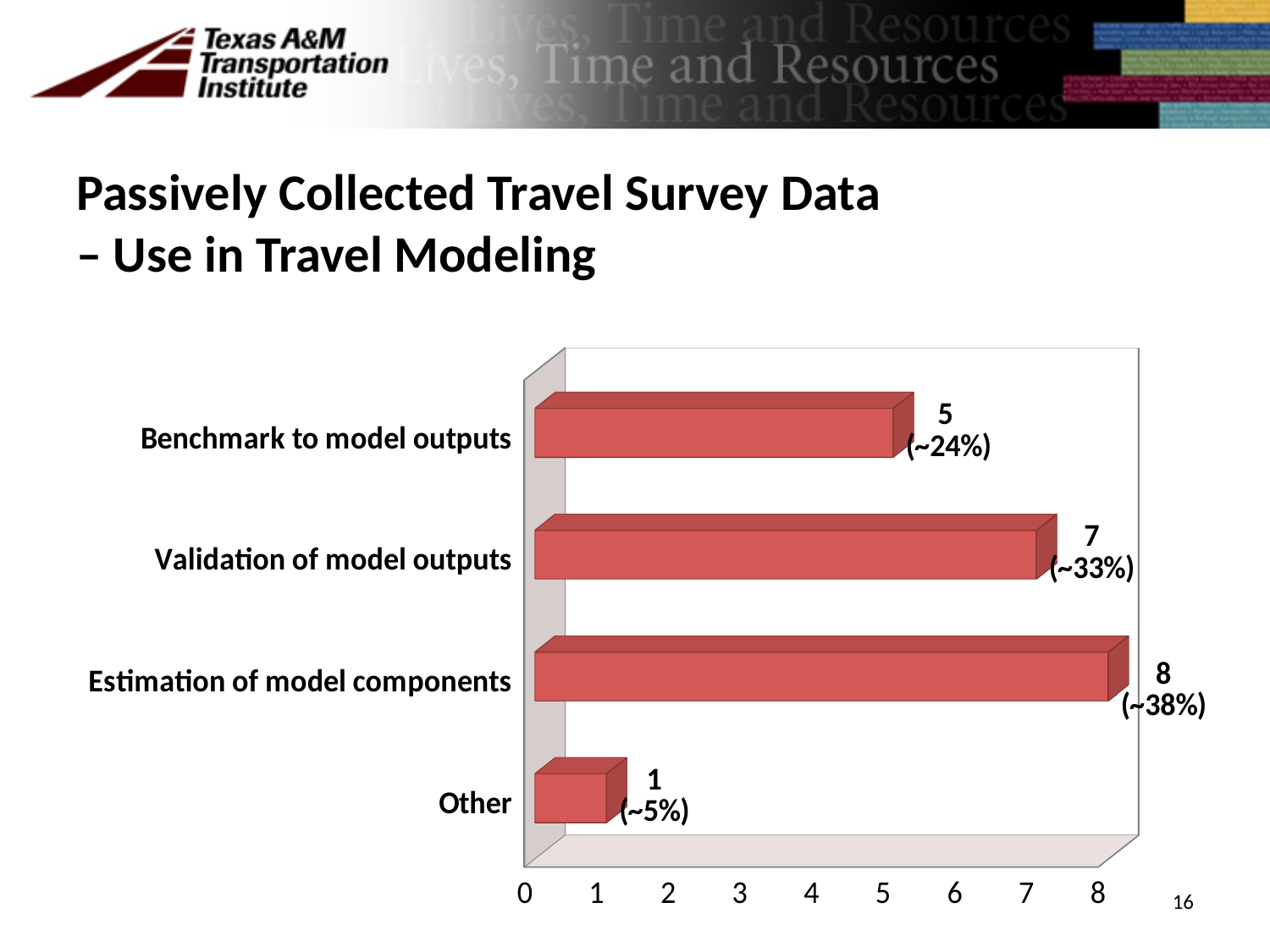
What is the maximum value shown on the horizontal axis? 8 How many categories are shown in the chart? 4 Which category has the lowest value? Other What percentage is shown next to the bar for Validation of model outputs? ~33% What is the value for Benchmark to model outputs? 5 What is the value for Other? 1 What is the value for Validation of model outputs? 7 Which is larger, the value for Validation of model outputs or the value for Benchmark to model outputs? Validation of model outputs What is the difference between the values for Estimation of model components and Benchmark to model outputs? 3 Which category has the highest value? Estimation of model components What kind of chart is shown on the slide? Bar chart What is the value for Estimation of model components? 8